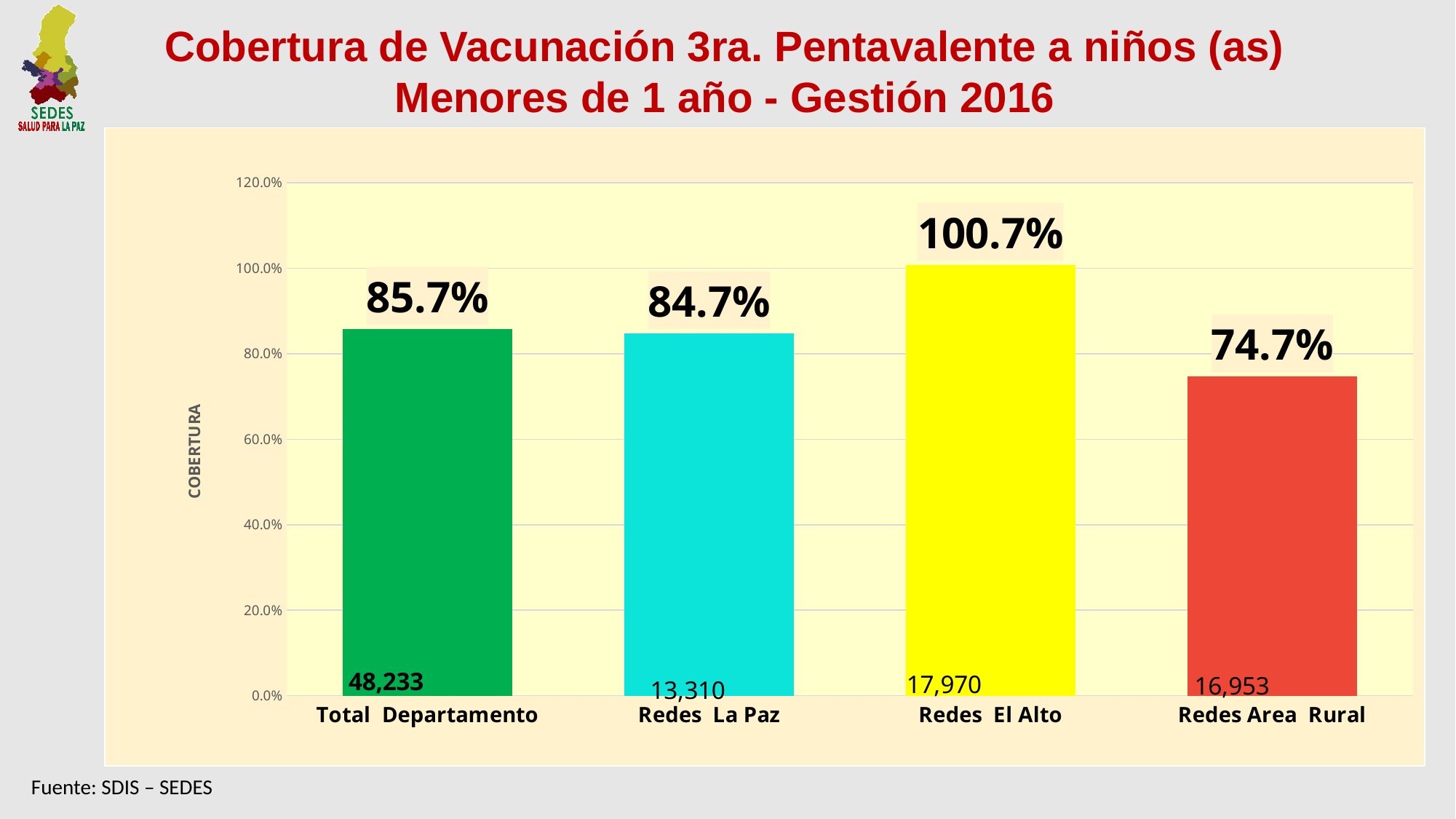
What is the coverage value shown for Redes Area Rural? 74.7% What is the coverage value shown for Total Departamento? 85.7% How many categories are shown on the x axis? 4 Which has higher coverage, Redes La Paz or Redes Area Rural? Redes La Paz What number is printed at the base of the Redes La Paz bar? 13,310 Which category has the highest coverage? Redes El Alto What is the difference in coverage between Redes El Alto and Redes Area Rural? 26.0% What kind of chart is shown on the slide? Bar chart Which category has the lowest coverage? Redes Area Rural What is the difference in coverage between Total Departamento and Redes La Paz? 1.0% What is the coverage value shown for Redes El Alto? 100.7% What is the label on the vertical axis of the chart? COBERTURA